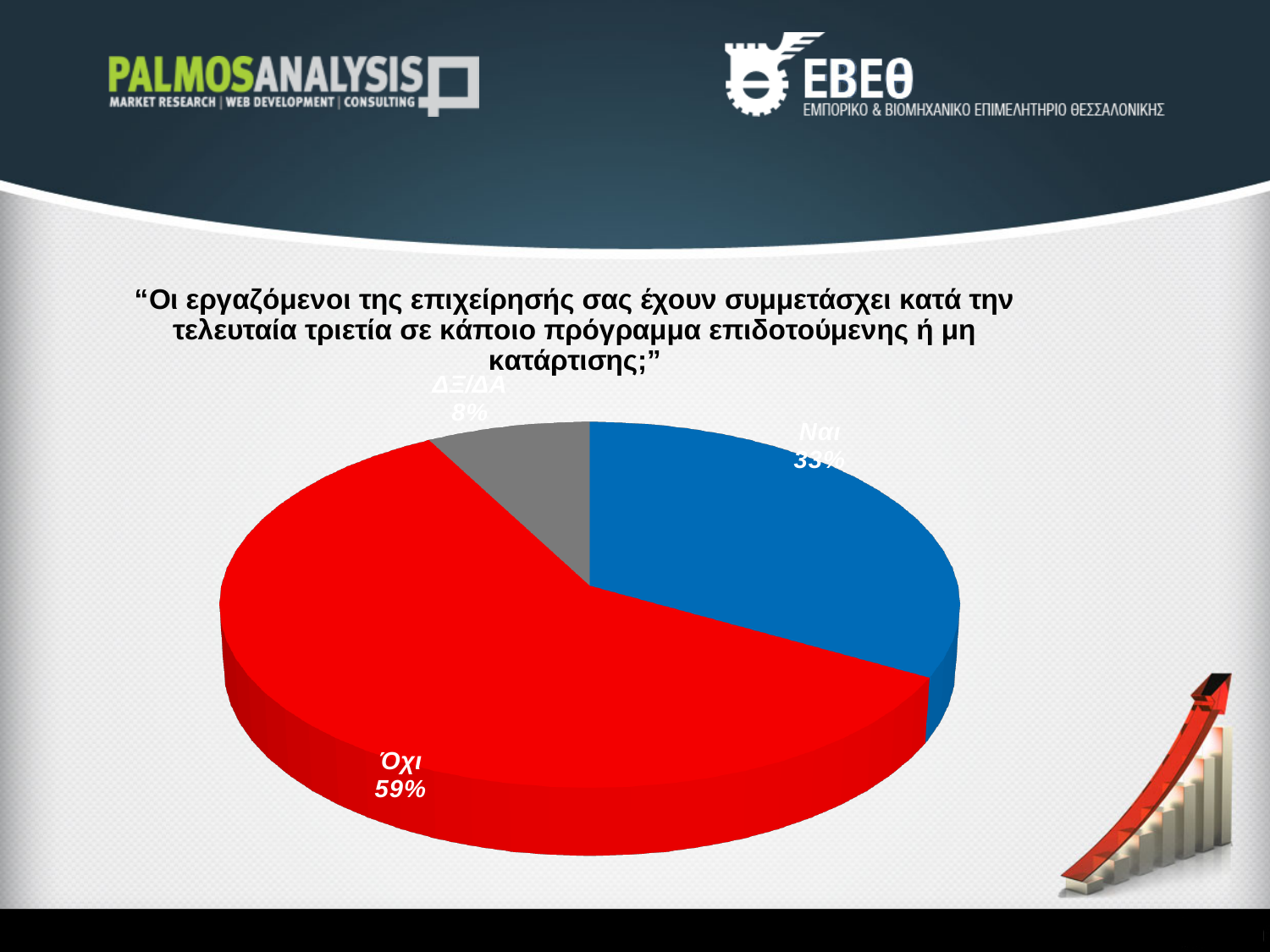
What colour is the Ναι slice of the pie chart? Blue Which slice of the pie chart is the smallest? ΔΞ/ΔΑ What colour is the Όχι slice of the pie chart? Red How many slices does the pie chart have? 3 Which is larger, the Ναι slice or the ΔΞ/ΔΑ slice? Ναι What kind of chart is shown on the slide? Pie chart What percentage of the pie chart is labelled Ναι? 33% Which slice of the pie chart is the largest? Όχι What percentage of the pie chart is labelled ΔΞ/ΔΑ? 8% What percentage of the pie chart is labelled Όχι? 59% What is the combined share of the Ναι and ΔΞ/ΔΑ slices? 41% What is the difference in percentage points between the Όχι slice and the Ναι slice? 26